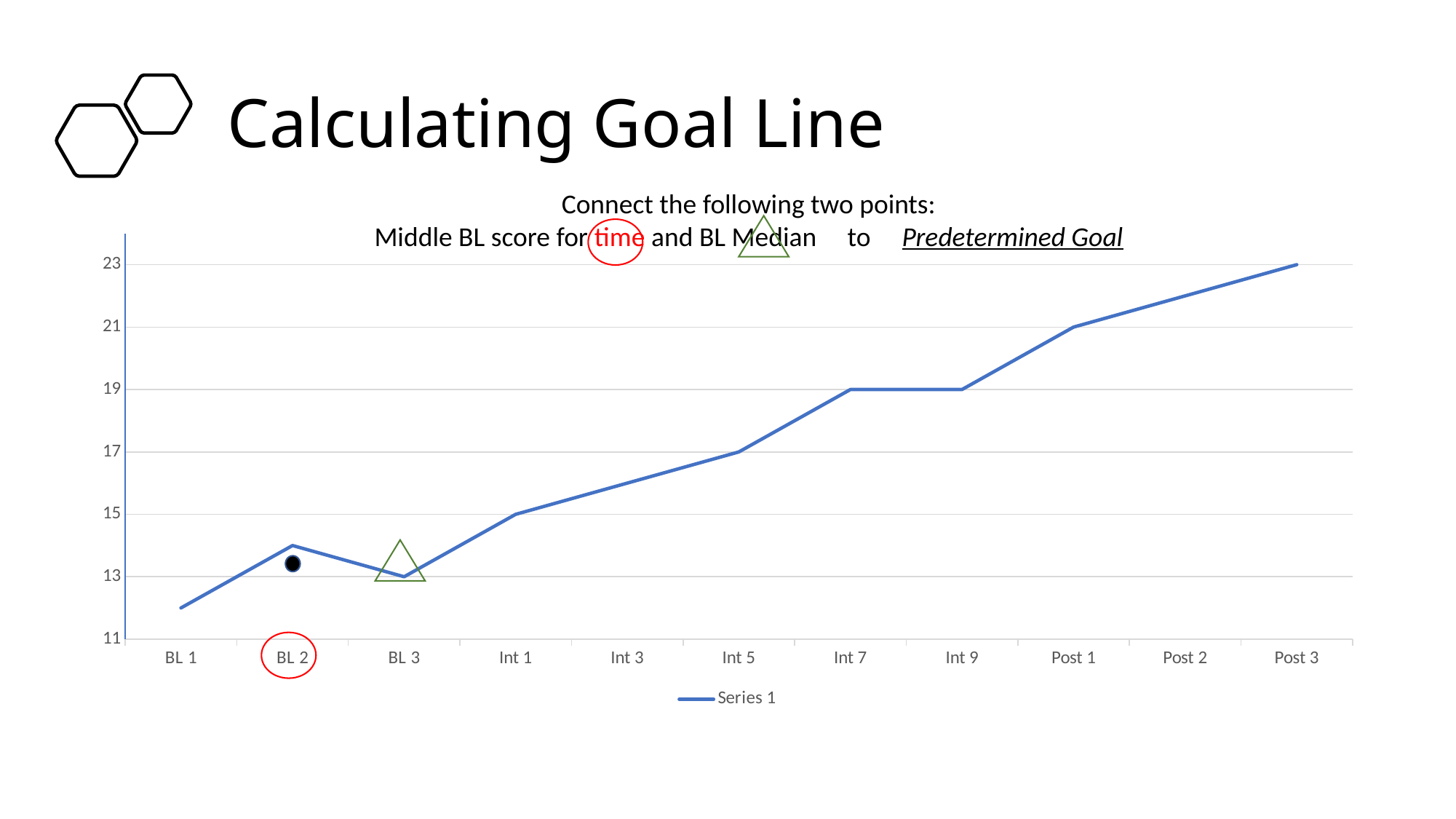
What is the difference between the values for Post 3 and Int 1? 8 What is the value for Int 5? 17 What is the name of the series shown in the legend? Series 1 Which category has the highest value? Post 3 What is the value for Post 3? 23 How many series does the legend list? 1 How many categories are plotted along the x axis? 11 What is the value for Post 1? 21 What kind of chart is shown on the slide? line chart Is the value for BL 2 greater or less than 13? greater What is the value for BL 3? 13 Which category has the lowest value? BL 1